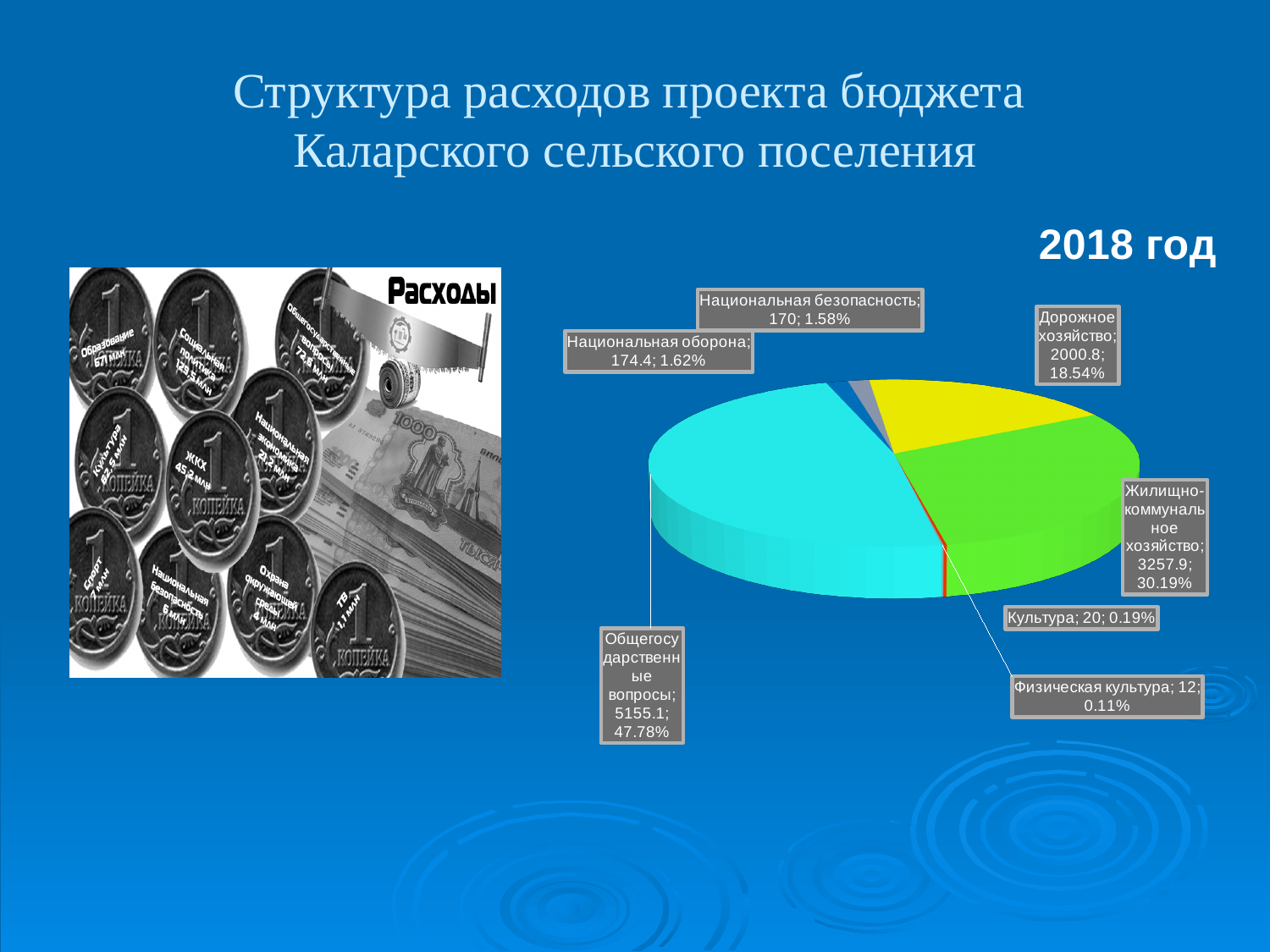
Which is larger, the value for Национальная оборона or for Национальная безопасность? Национальная оборона What share of the pie does Культура have? 0.19% What is the difference between the values for Жилищно-коммунальное хозяйство and Дорожное хозяйство? 1257.1 Which category has the smallest value? Физическая культура What kind of chart is shown on the slide? pie chart What share of the pie does Жилищно-коммунальное хозяйство have? 30.19% What value is shown for Дорожное хозяйство? 2000.8 Which category has the largest value? Общегосударственные вопросы What value is shown for Общегосударственные вопросы? 5155.1 Which year does the chart refer to, according to the label above it? 2018 год What share of the pie does Национальная оборона have? 1.62% How many categories does the pie chart show? 7